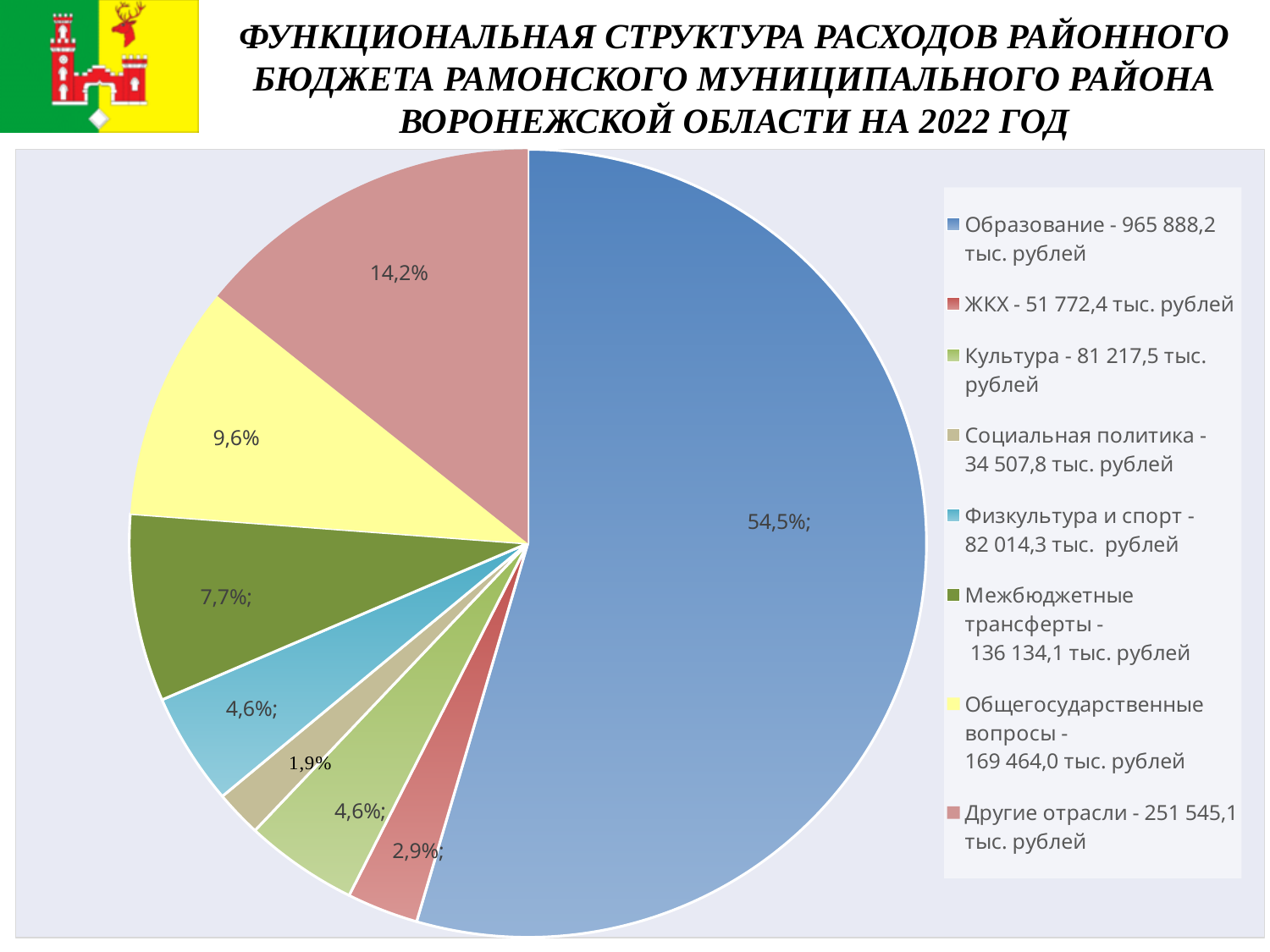
What share of the pie does Другие отрасли take? 14,2% Which category has the smallest slice of the pie? Социальная политика What amount in тыс. рублей does the legend give for ЖКХ? 51 772,4 тыс. рублей What share of the pie does Социальная политика take? 1,9% What share of the pie does Общегосударственные вопросы take? 9,6% What amount in тыс. рублей does the legend give for Межбюджетные трансферты? 136 134,1 тыс. рублей What kind of chart is shown on the slide? pie chart Which category has the largest slice of the pie? Образование Which slice is larger: Общегосударственные вопросы or Межбюджетные трансферты? Общегосударственные вопросы How many slices does the pie chart have? 8